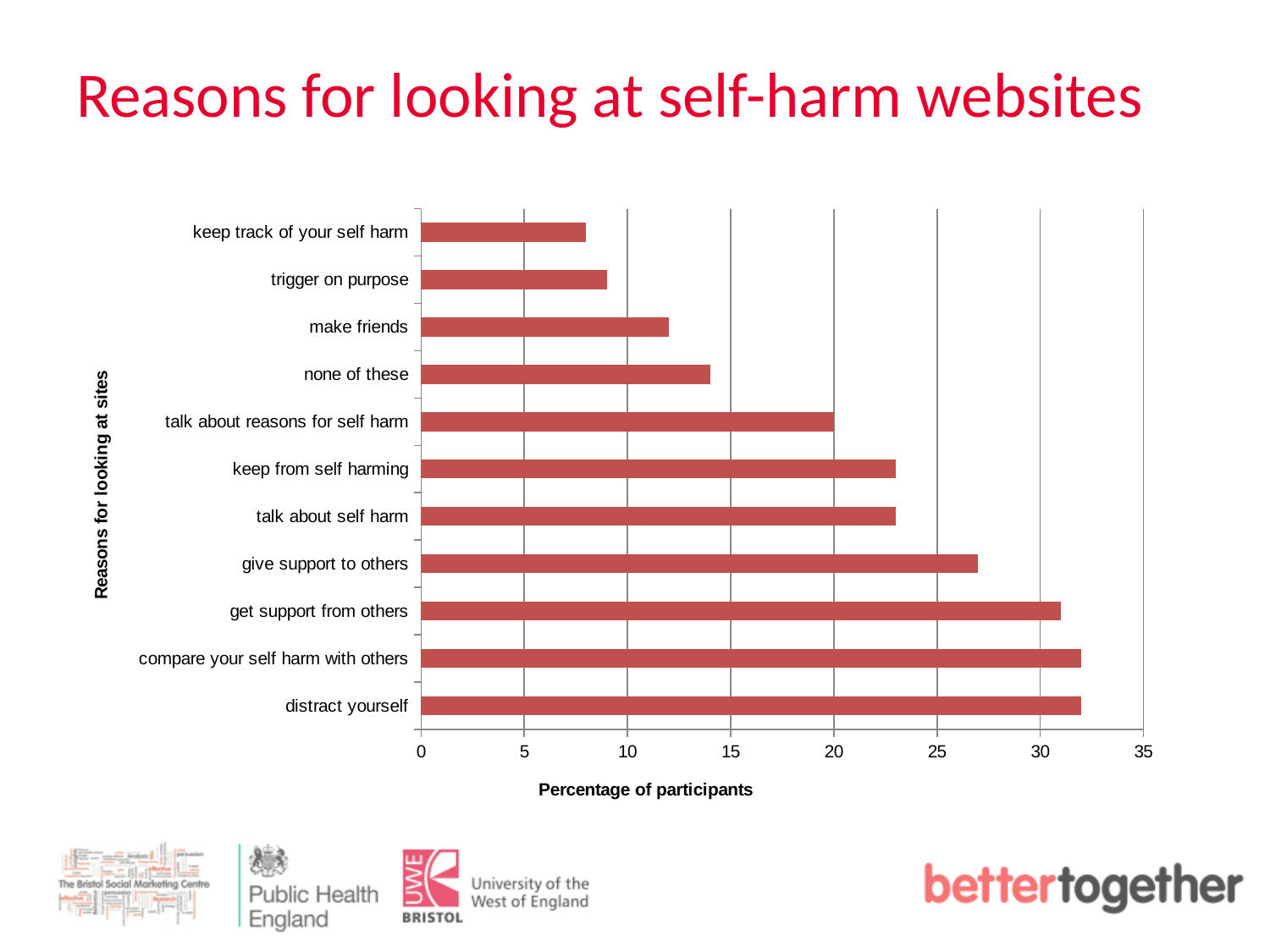
What is the percentage of participants for 'talk about reasons for self harm'? 20 Which has a higher percentage of participants: 'give support to others' or 'make friends'? give support to others Is the value for 'keep from self harming' greater or less than 20? greater Is the value for 'make friends' greater or less than 15? less Is the value for 'give support to others' greater or less than 25? greater What is the title of the vertical axis? Reasons for looking at sites Which reason has the lowest percentage of participants? keep track of your self harm How many reasons (categories) are plotted in the chart? 11 What kind of chart is shown on the slide? bar chart What is the title of the horizontal axis? Percentage of participants